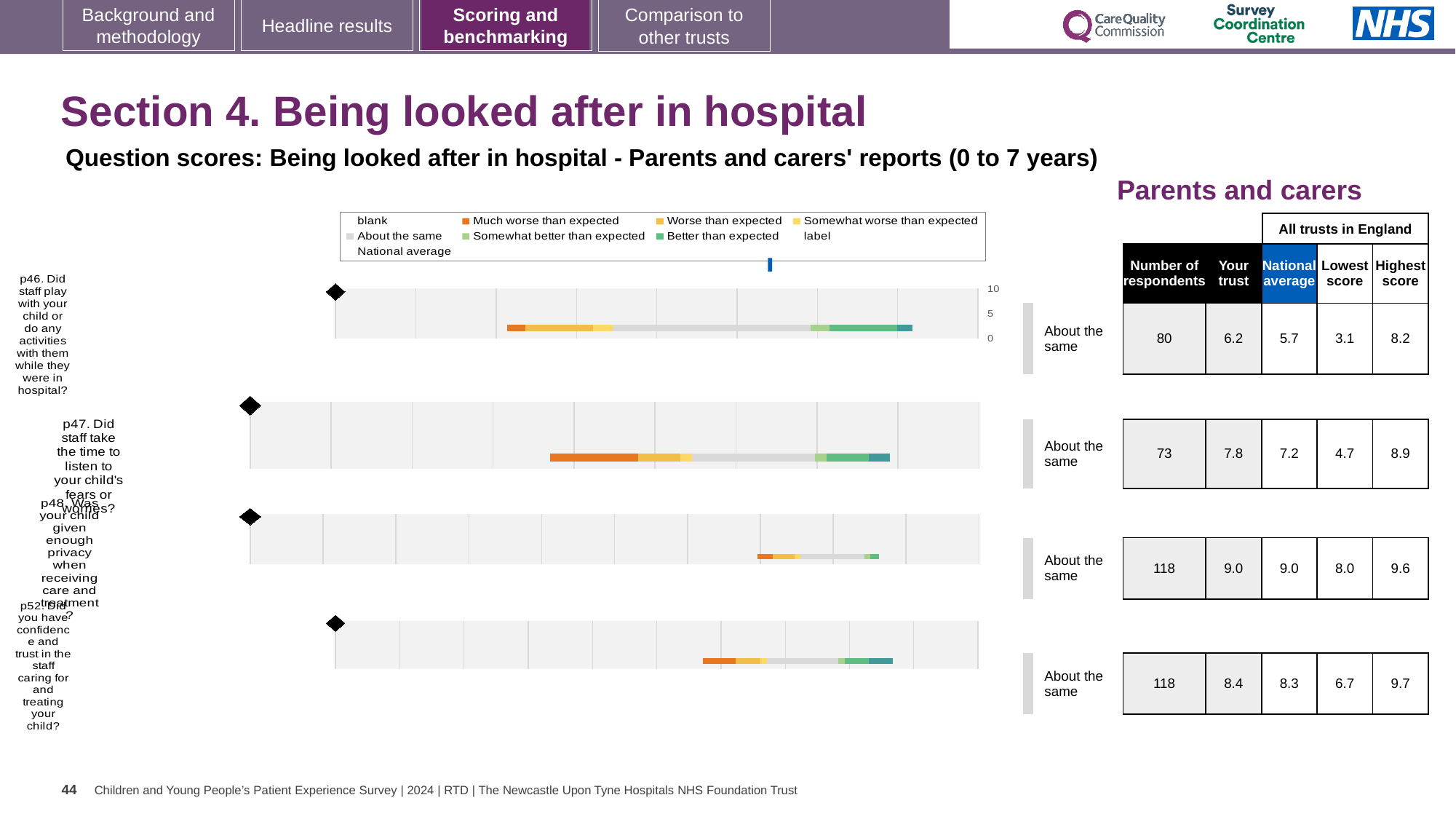
Which question has the lowest 'Your trust' score? p46 How many respondents are listed for p48 (Was your child given enough privacy when receiving care and treatment?)? 118 What is the highest score among all trusts in England for p52? 9.7 What kind of chart is used to show the question scores on this slide? Bar chart For p46 (Did staff play with your child or do any activities with them while they were in hospital?), what is the 'Your trust' score? 6.2 For p47, what is the difference between the 'Your trust' score (7.8) and the national average (7.2)? 0.6 Which question has the highest 'Your trust' score? p48 How many survey questions (p46, p47, p48, p52) are plotted on the slide? 4 For p47 (Did staff take the time to listen to your child's fears or worries?), what is the national average score? 7.2 What benchmark category is shown for p46? About the same What colour does the legend use for 'Much worse than expected'? Orange For p52 (Did you have confidence and trust in the staff caring for and treating your child?), which is larger: the 'Your trust' score or the national average? Your trust